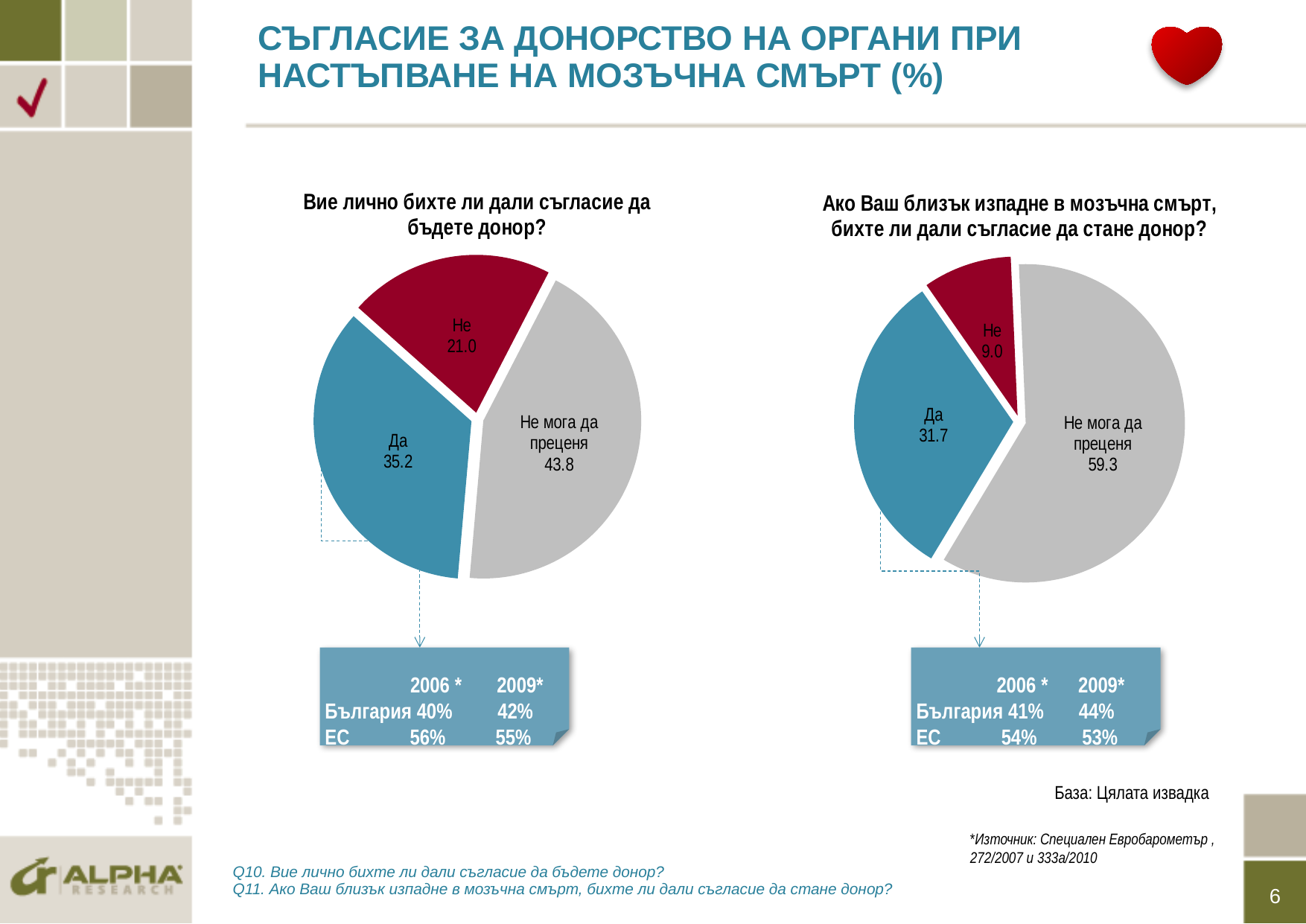
What colour is the "Не" slice in the left pie chart? Dark red In the right pie chart, what is the value for "Не"? 9.0 In the left pie chart, what is the difference between "Да" and "Не"? 14.2 In the left pie chart, which category has the largest slice? Не мога да преценя In the right pie chart, what is the value for "Не мога да преценя"? 59.3 What type of chart is the left chart? Pie chart In the right pie chart, which category has the smallest slice? Не In the right pie chart, what is the difference between "Не мога да преценя" and "Да"? 27.6 How many slices does the right pie chart have? 3 Which is larger: "Да" in the left pie chart or "Да" in the right pie chart? Да in the left pie chart In the left pie chart, what is the value for "Не"? 21.0 In the left pie chart, what is the value for "Да"? 35.2